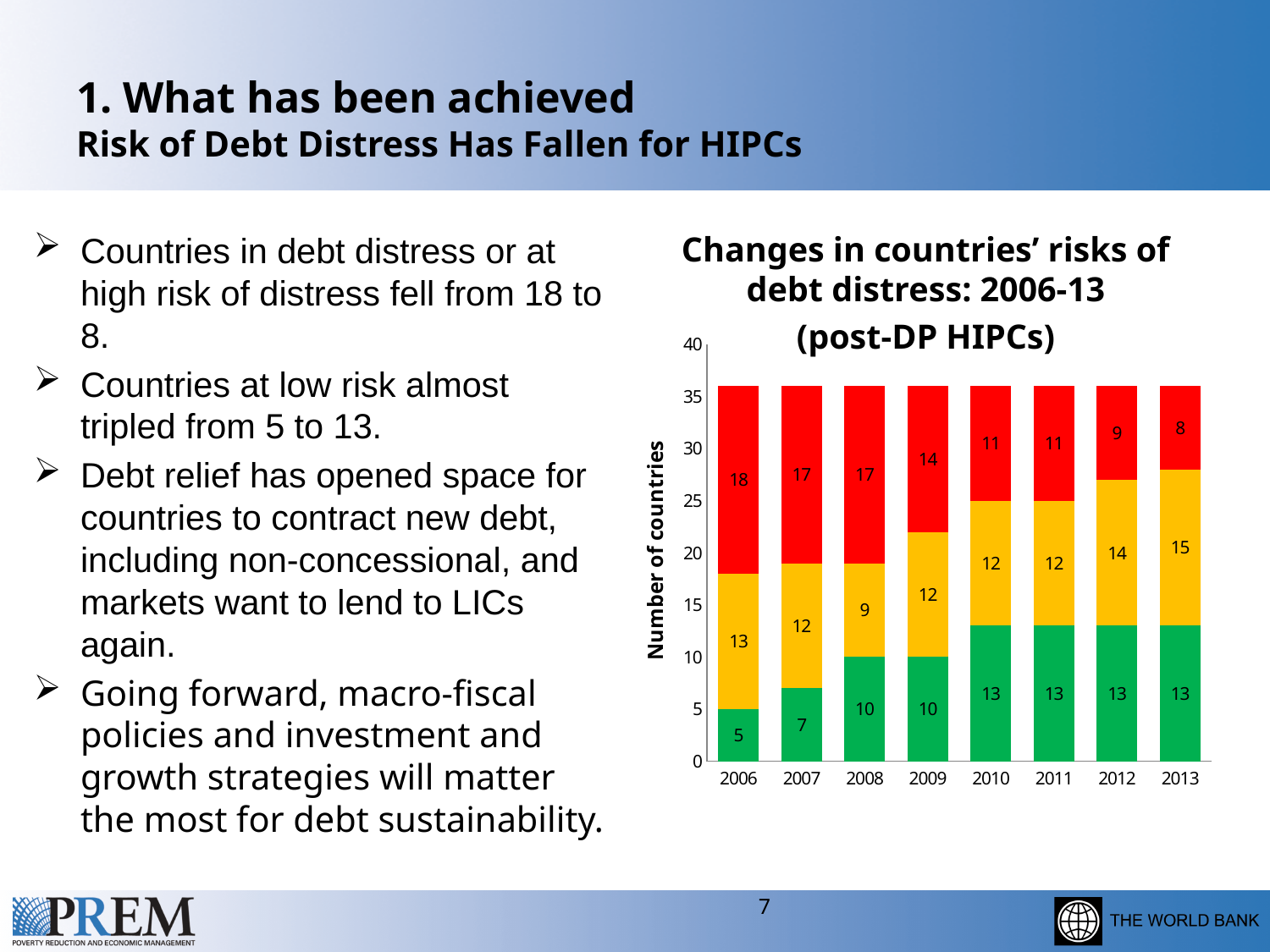
What type of chart is shown on the slide? stacked bar chart What is the value of the yellow (middle) segment for 2013? 15 How many years are shown on the x axis of the chart? 8 In which year is the green (bottom) segment the smallest? 2006 What is the difference between the red segment value in 2006 and in 2013? 10 What is the title of the chart? Changes in countries' risks of debt distress: 2006-13 (post-DP HIPCs) What is the value of the green (bottom) segment for 2007? 7 What is the label on the vertical axis of the chart? Number of countries Which is larger, the yellow segment in 2008 or the yellow segment in 2012? 2012 What is the total height of the stacked bar for 2010? 36 What is the value of the red (top) segment for 2006? 18 In which year is the red (top) segment the largest? 2006